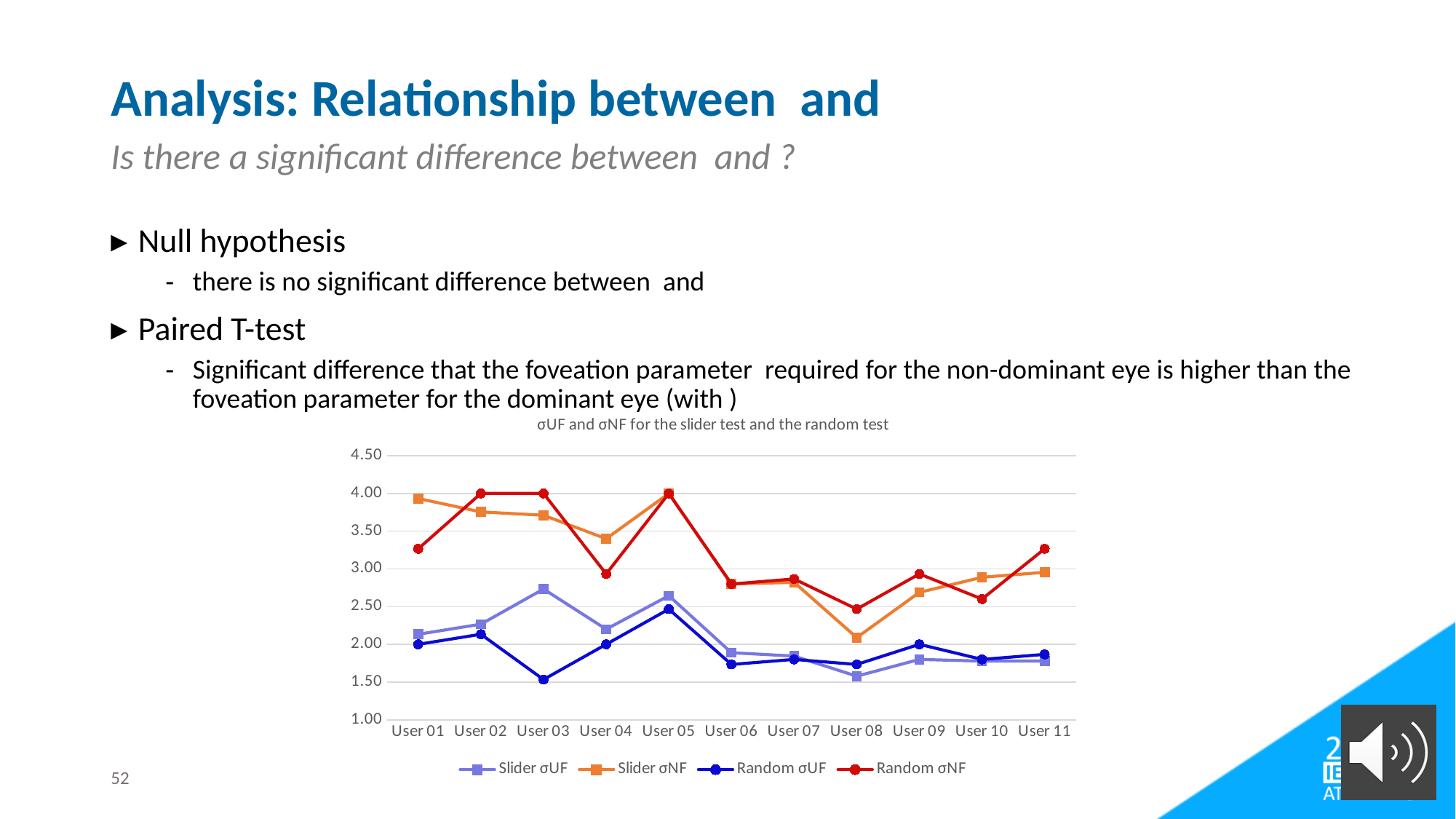
For User 04, which is larger: Slider σNF or Random σNF? Slider σNF Is the Slider σNF value for User 08 greater or less than 2.50? less How many users are plotted along the x axis of the chart? 11 What is the Random σUF value for User 01? 2.00 What is the Random σNF value for User 02? 4.00 Is the Random σNF value for User 11 greater or less than 3.00? greater Which user has the lowest Random σUF value? User 03 How many series does the chart legend list? 4 What is the title of the chart? σUF and σNF for the slider test and the random test What kind of chart is shown on the slide? line chart Which user has the lowest Slider σNF value? User 08 Is the Random σUF value for User 03 greater or less than 2.00? less